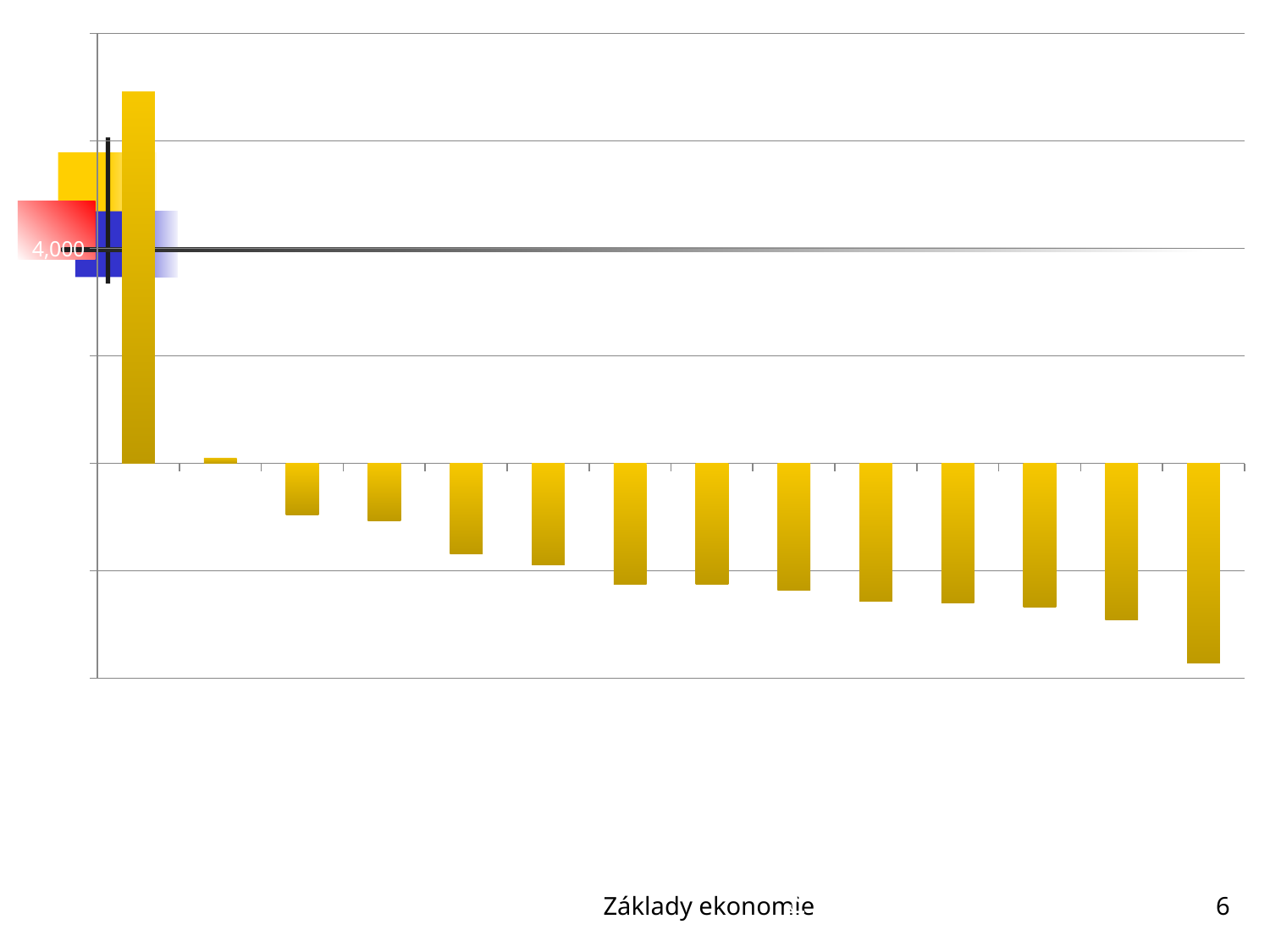
Is the value of the last bar greater or less than 4,000? less How many bars are plotted in the chart? 14 Do the bar values rise or fall from left to right along the x axis? fall Which bar in the chart is the highest? the first bar How many bars in the chart extend below the zero line? 12 Is the value of the first bar greater or less than 4,000? greater Which is larger, the first bar or the last bar? the first bar Which bar in the chart is the lowest? the last bar What kind of chart is shown on the slide? bar chart What colour are the bars in the chart? yellow What number is printed on the label at the left of the chart? 4,000